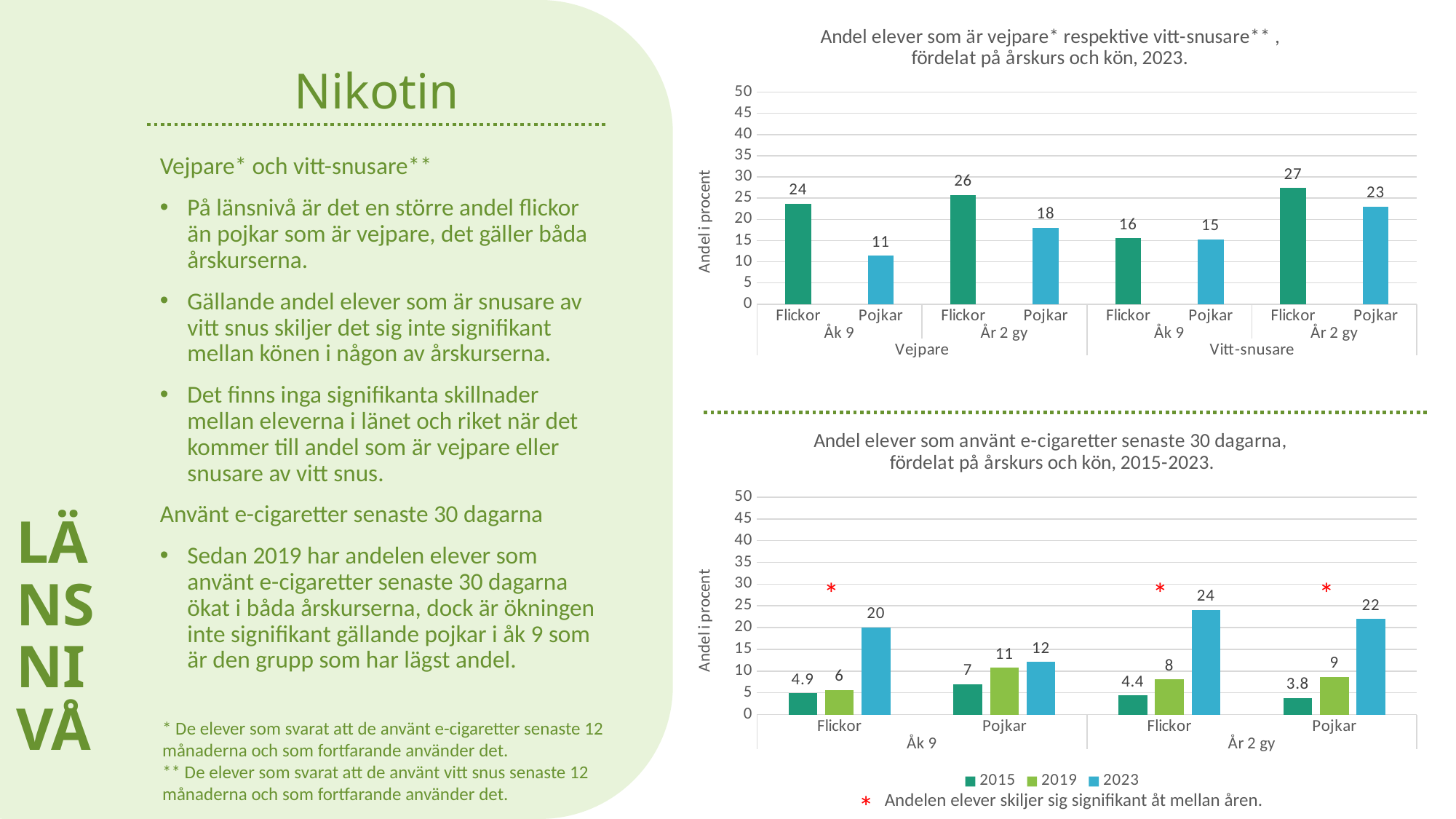
In the bottom chart (e-cigaretter 2015-2023), which is larger for Pojkar in Åk 9: 2019 or 2023? 2023 In the top chart (vejpare/vitt-snusare 2023), which bar has the highest value? Flickor, År 2 gy, Vitt-snusare In the top chart (vejpare/vitt-snusare 2023), what is the value for Pojkar in År 2 gy under Vitt-snusare? 23 In the top chart (vejpare/vitt-snusare 2023), how many bars are plotted? 8 In the top chart (vejpare/vitt-snusare 2023), what is the difference between Flickor and Pojkar in Åk 9 under Vejpare? 13 What kind of chart is the bottom chart (e-cigaretter 2015-2023)? Bar chart In the bottom chart (e-cigaretter 2015-2023), what is the value for Pojkar in År 2 gy in 2023? 22 In the bottom chart (e-cigaretter 2015-2023), what is the difference between 2023 and 2015 for Flickor in År 2 gy? 19.6 In the top chart (vejpare/vitt-snusare 2023), which bar has the lowest value? Pojkar, Åk 9, Vejpare In the top chart (vejpare/vitt-snusare 2023), what is the value for Flickor in Åk 9 under Vejpare? 24 In the bottom chart (e-cigaretter 2015-2023), what is the value for Flickor in Åk 9 in 2015? 4.9 In the bottom chart (e-cigaretter 2015-2023), how many series does the legend list? 3